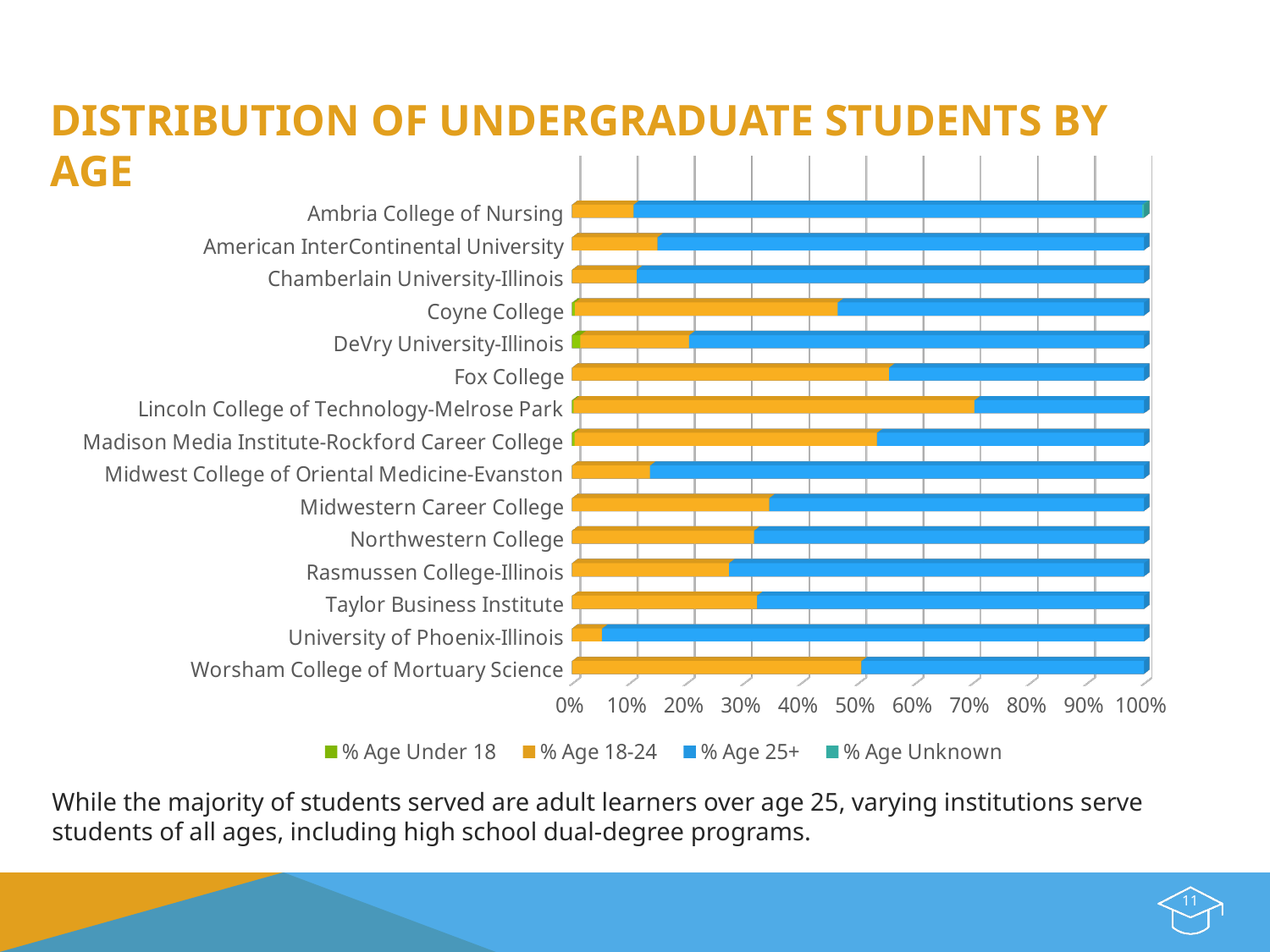
Which institution has the smallest % Age 18-24 segment? University of Phoenix-Illinois How many series does the legend list? 4 Is the % Age 18-24 value for Rasmussen College-Illinois greater or less than 30%? less What kind of chart is shown on the slide? bar chart Which has a larger % Age 18-24 segment, Coyne College or DeVry University-Illinois? Coyne College Which institution has the largest % Age 25+ segment? University of Phoenix-Illinois Is the % Age 18-24 value for University of Phoenix-Illinois greater or less than 10%? less How many institutions are listed on the chart? 15 What is the title of the chart? Distribution of Undergraduate Students by Age Is the % Age 18-24 value for Fox College greater or less than 50%? greater Which institution has the largest % Age 18-24 segment? Lincoln College of Technology-Melrose Park